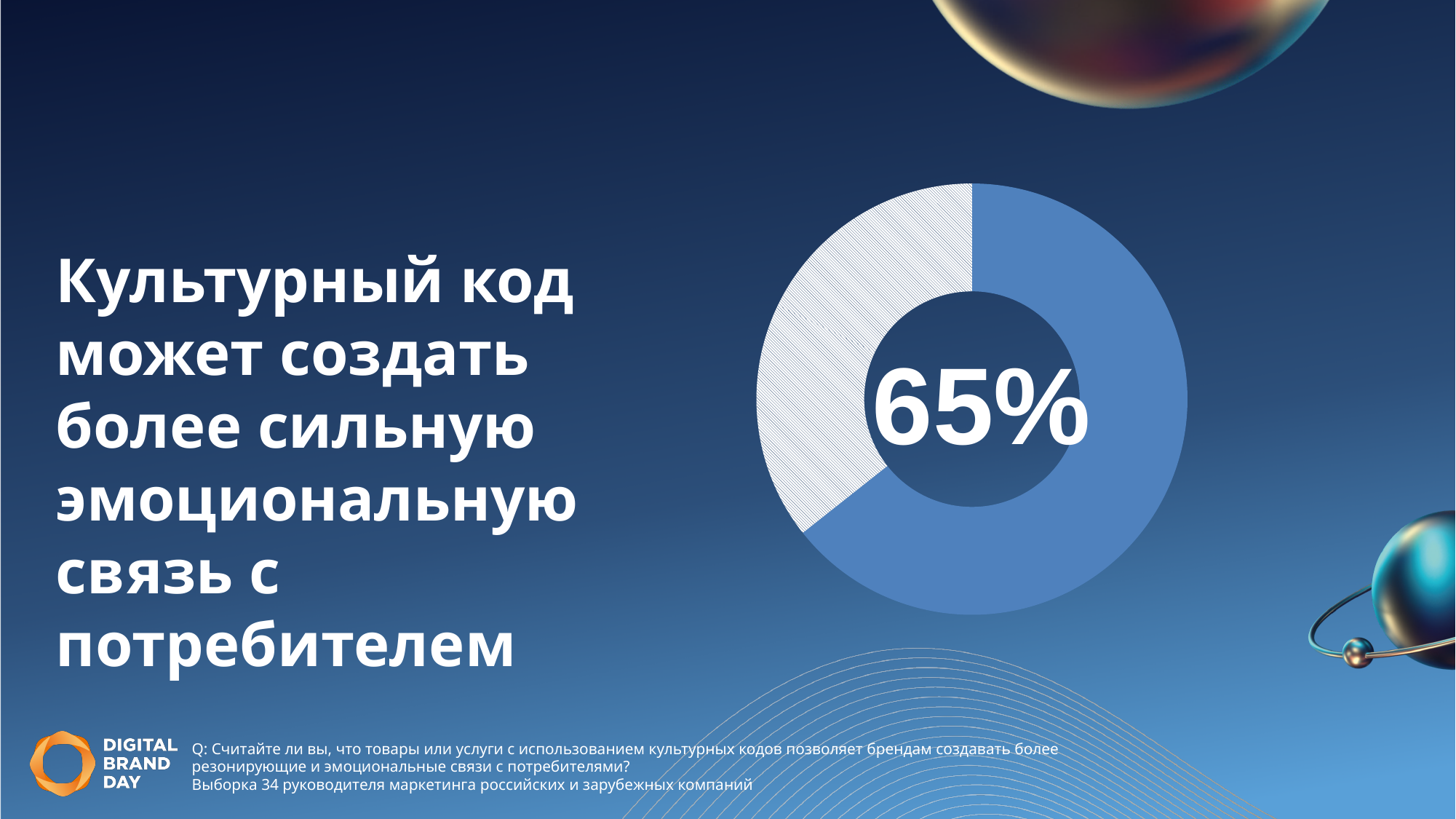
What share of the donut chart does the solid blue segment represent? 65% What is the headline statement next to the chart? Культурный код может создать более сильную эмоциональную связь с потребителем What percentage is printed in the centre of the donut chart? 65% According to the footnote, how many marketing executives were in the sample for this chart? 34 What kind of chart is shown on the slide? Donut (pie) chart Which segment of the donut chart is larger, the solid blue one or the hatched white one? The solid blue one Is the share shown by the solid blue segment greater or less than 50%? greater